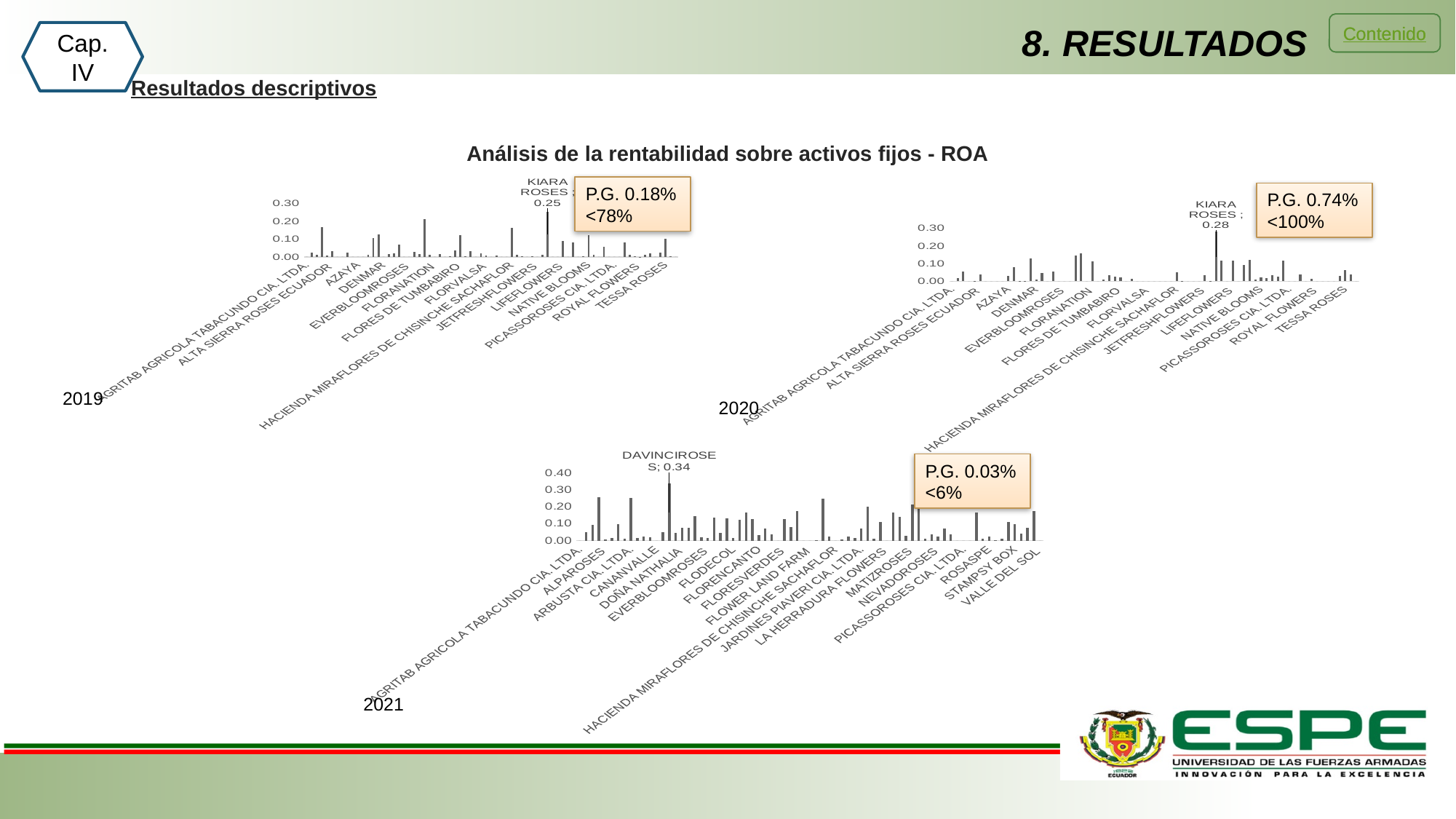
What is the overall title shown above the charts? Análisis de la rentabilidad sobre activos fijos - ROA In the 2021 chart, is the value for DAVINCIROSES greater or less than 0.30? greater In the 2021 chart, what ROA value is labelled for DAVINCIROSES? 0.34 What is the difference between the labelled DAVINCIROSES value in the 2021 chart and the labelled KIARA ROSES value in the 2020 chart? 0.06 In the 2020 chart, which company has the highest ROA? KIARA ROSES Is the labelled value for KIARA ROSES in the 2019 chart larger or smaller than the labelled value for KIARA ROSES in the 2020 chart? smaller In the 2019 chart, what ROA value is labelled for KIARA ROSES? 0.25 What kind of chart is used for the 2019 ROA data? bar chart What is the difference between the labelled KIARA ROSES value in the 2020 chart and in the 2019 chart? 0.03 What is the highest tick value on the vertical axis of the 2021 chart? 0.40 In the 2021 chart, which company has the highest ROA? DAVINCIROSES In the 2020 chart, what ROA value is labelled for KIARA ROSES? 0.28